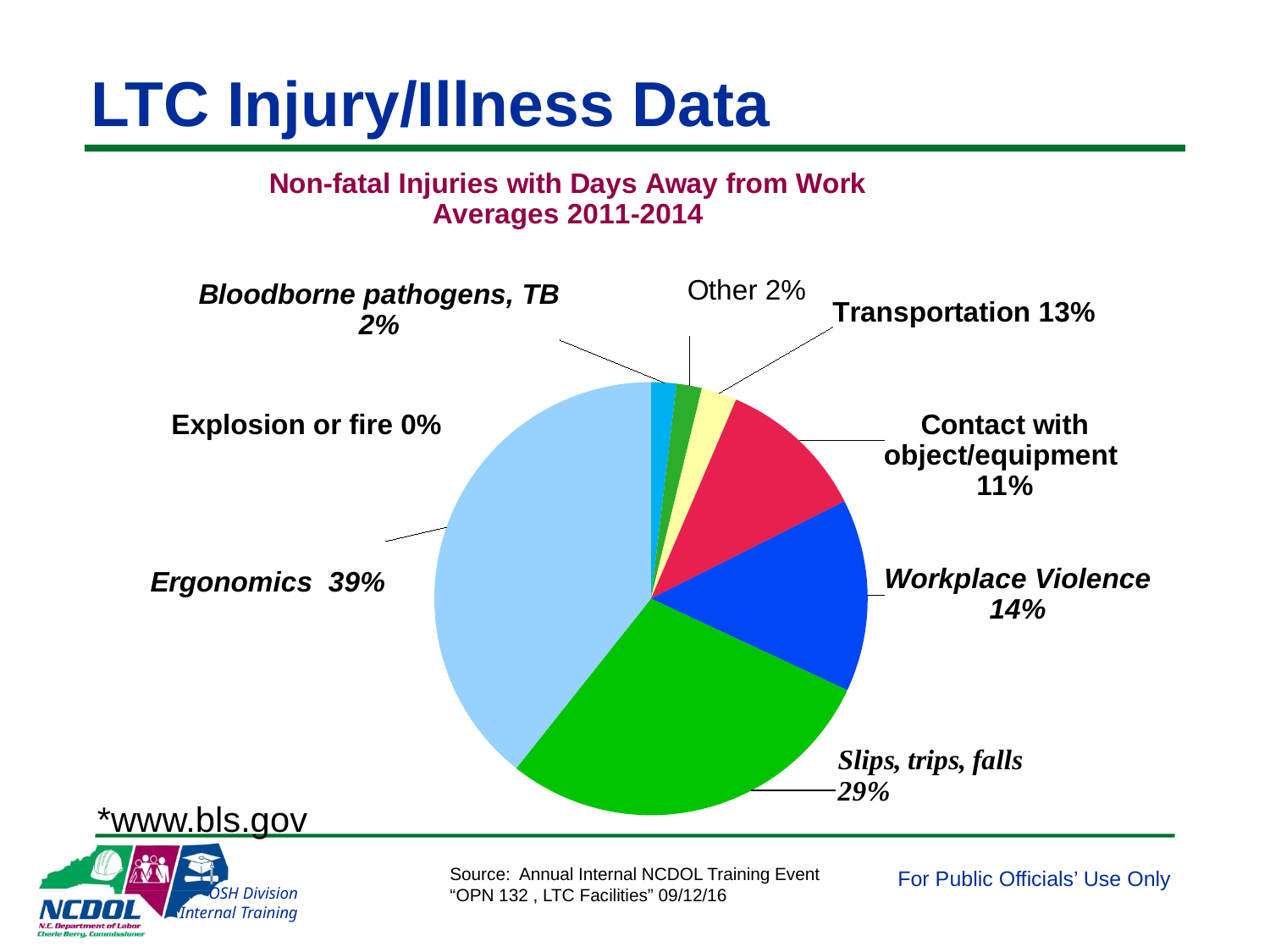
What is the title of the chart? Non-fatal Injuries with Days Away from Work Averages 2011-2014 What is the difference between the Ergonomics share and the Slips, trips, falls share? 10% What share of the pie is Workplace Violence? 14% What share of the pie is Slips, trips, falls? 29% Which category has the smallest share of the pie? Explosion or fire What share of the pie is Explosion or fire? 0% Which is larger, the share for Workplace Violence or the share for Transportation? Workplace Violence What share of the pie is Transportation? 13% What share of the pie is Ergonomics? 39% What share of the pie is Contact with object/equipment? 11% Which category has the largest share of the pie? Ergonomics What kind of chart is shown on the slide? pie chart